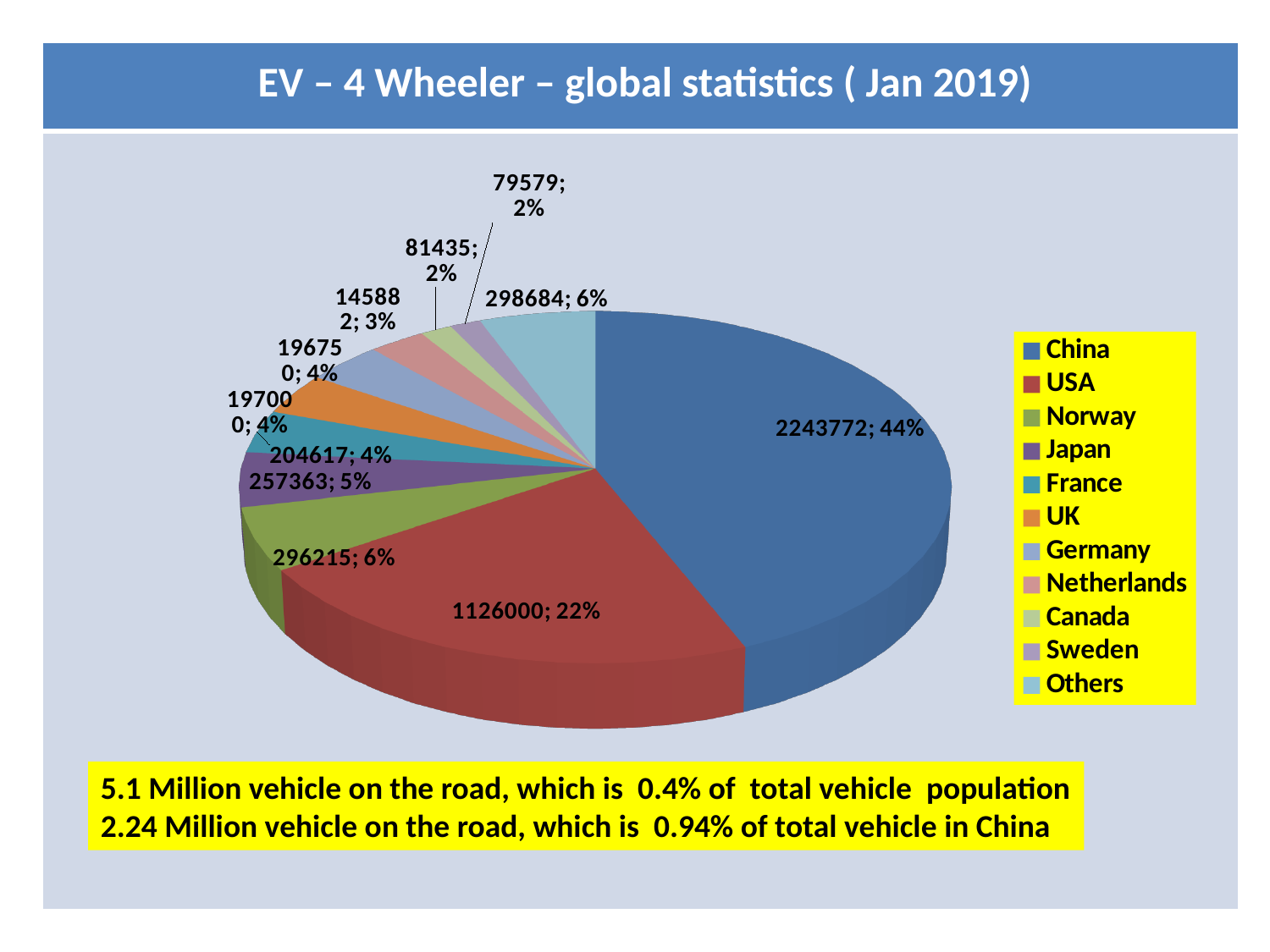
What is the value shown for USA in the pie chart? 1126000 Which is larger, the value for Norway or the value for Japan? Norway What is the title of the chart on the slide? EV – 4 Wheeler – global statistics ( Jan 2019) How many categories does the legend of the pie chart list? 11 What is the value shown for Japan in the pie chart? 257363 What is the difference between the values for China and USA? 1117772 Which category has the largest slice of the pie? China What share of the pie does USA account for? 22% What kind of chart is shown on the slide? pie chart What share of the pie does China account for? 44% What share of the pie does Others account for? 6% What is the value shown for China in the pie chart? 2243772